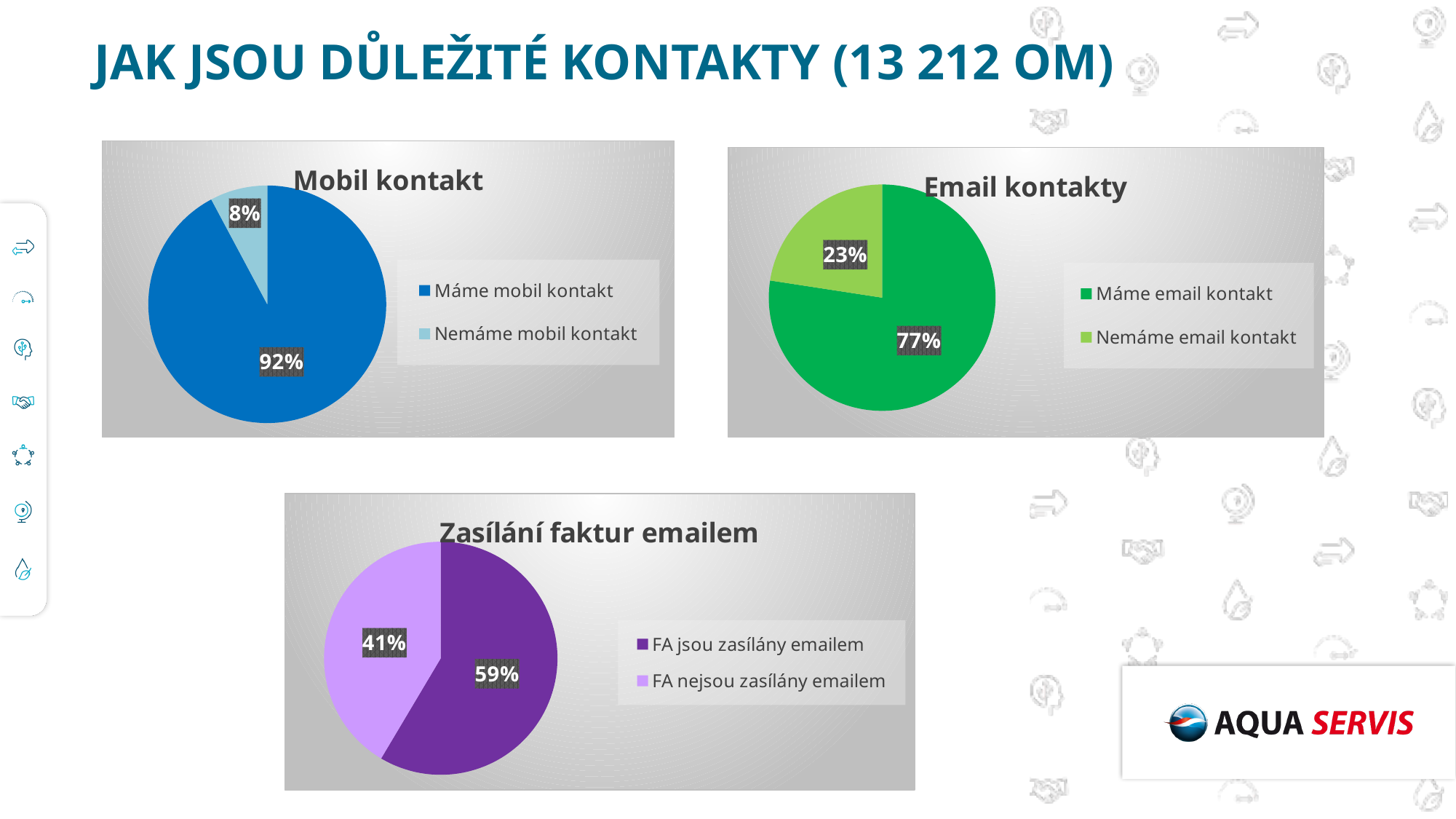
What type of chart is 'Zasílání faktur emailem'? Pie chart In the 'Zasílání faktur emailem' chart, what share is labelled for 'FA nejsou zasílány emailem'? 41% How many entries does the legend of the 'Email kontakty' chart list? 2 In the 'Mobil kontakt' chart, what share is labelled for 'Nemáme mobil kontakt'? 8% In the 'Email kontakty' chart, which slice is the smallest? Nemáme email kontakt Which is larger: the 'Nemáme email kontakt' share in the 'Email kontakty' chart or the 'Nemáme mobil kontakt' share in the 'Mobil kontakt' chart? Nemáme email kontakt In the 'Email kontakty' chart, what share is labelled for 'Máme email kontakt'? 77% In the 'Email kontakty' chart, what share is labelled for 'Nemáme email kontakt'? 23% In the 'Zasílání faktur emailem' chart, which slice is the largest? FA jsou zasílány emailem In the 'Mobil kontakt' chart, what is the difference in percentage points between 'Máme mobil kontakt' and 'Nemáme mobil kontakt'? 84 In the 'Mobil kontakt' chart, what share is labelled for 'Máme mobil kontakt'? 92% In the 'Zasílání faktur emailem' chart, what share is labelled for 'FA jsou zasílány emailem'? 59%